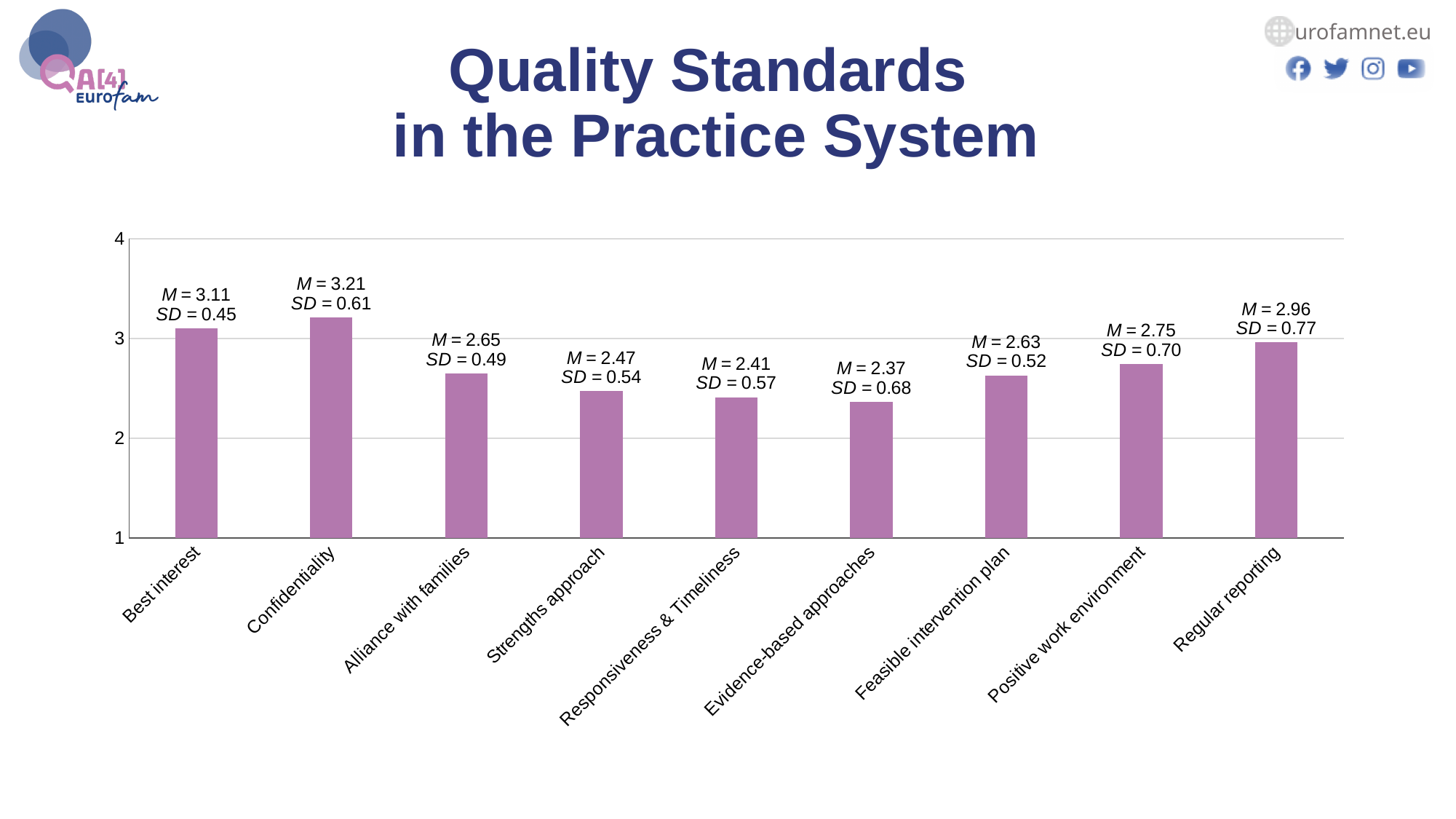
What is the mean (M) value for Confidentiality? 3.21 What is the difference between the mean values for Confidentiality and Best interest? 0.10 Which has a higher mean value, Positive work environment or Alliance with families? Positive work environment What is the title of the slide containing the chart? Quality Standards in the Practice System What is the SD value for Regular reporting? 0.77 Which category has the lowest mean value? Evidence-based approaches What is the difference between the mean values for Regular reporting and Feasible intervention plan? 0.33 How many categories are shown on the x axis? 9 Is the mean value for Strengths approach greater or less than 3? less What kind of chart is shown on the slide? bar chart Which category has the highest mean value? Confidentiality What is the mean (M) value for Evidence-based approaches? 2.37